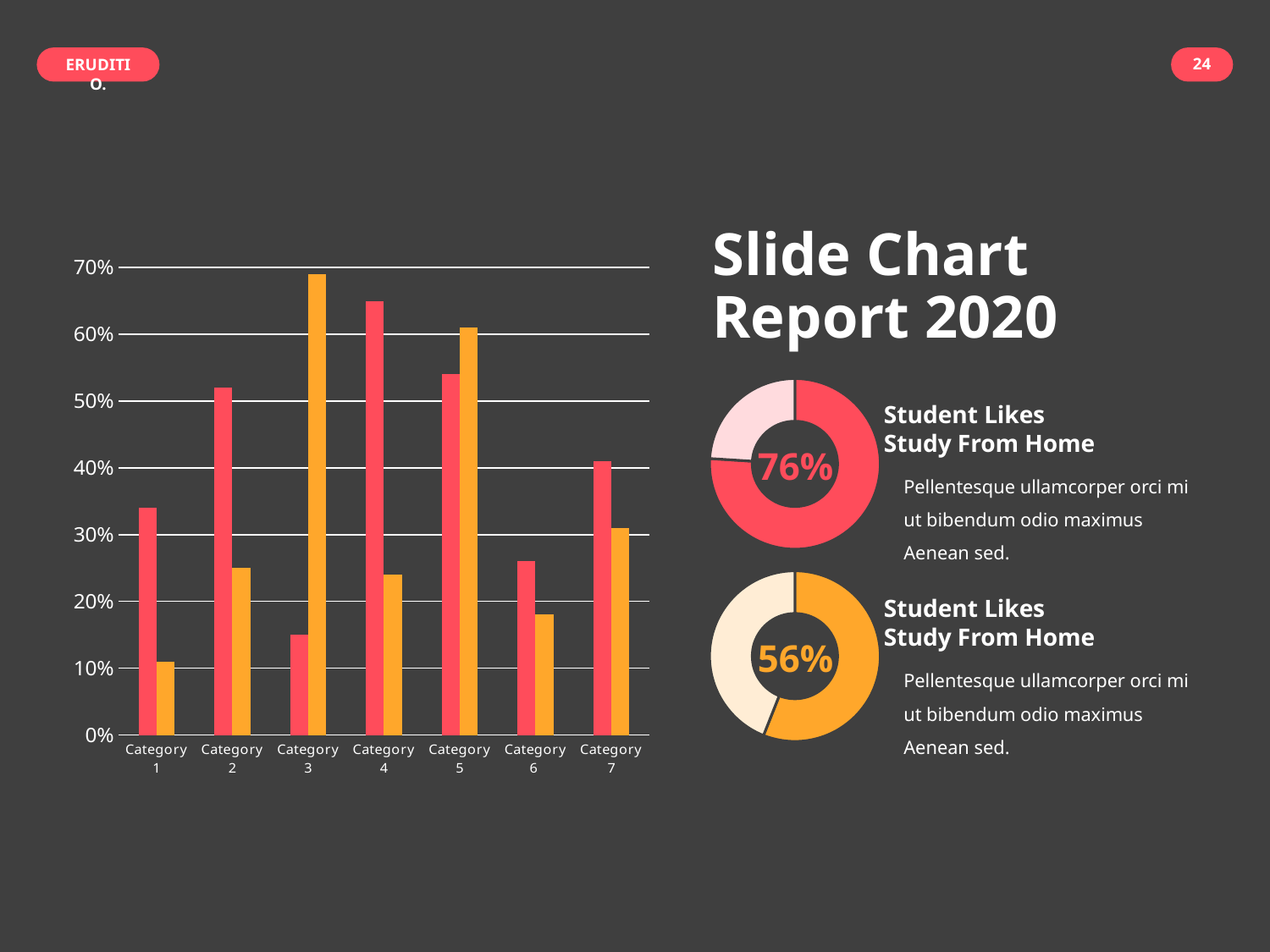
How many categories are shown on the x axis of the bar chart on the left? 7 What kind of chart is the large chart on the left of the slide? bar chart In the bar chart on the left, is the red bar for Category 4 greater or less than 60%? greater In the bar chart on the left, which category has the shortest orange bar? Category 1 In the bar chart on the left, is the orange bar for Category 1 greater or less than 20%? less In the bar chart on the left, is the orange bar for Category 3 greater or less than 60%? greater What percentage is shown in the centre of the lower donut chart on the right of the slide? 56% In the bar chart on the left, which category has the shortest red bar? Category 3 In the bar chart on the left, which category has the tallest orange bar? Category 3 What percentage is shown in the centre of the upper donut chart on the right of the slide? 76% In the bar chart on the left, which is larger for Category 2: the red bar or the orange bar? the red bar